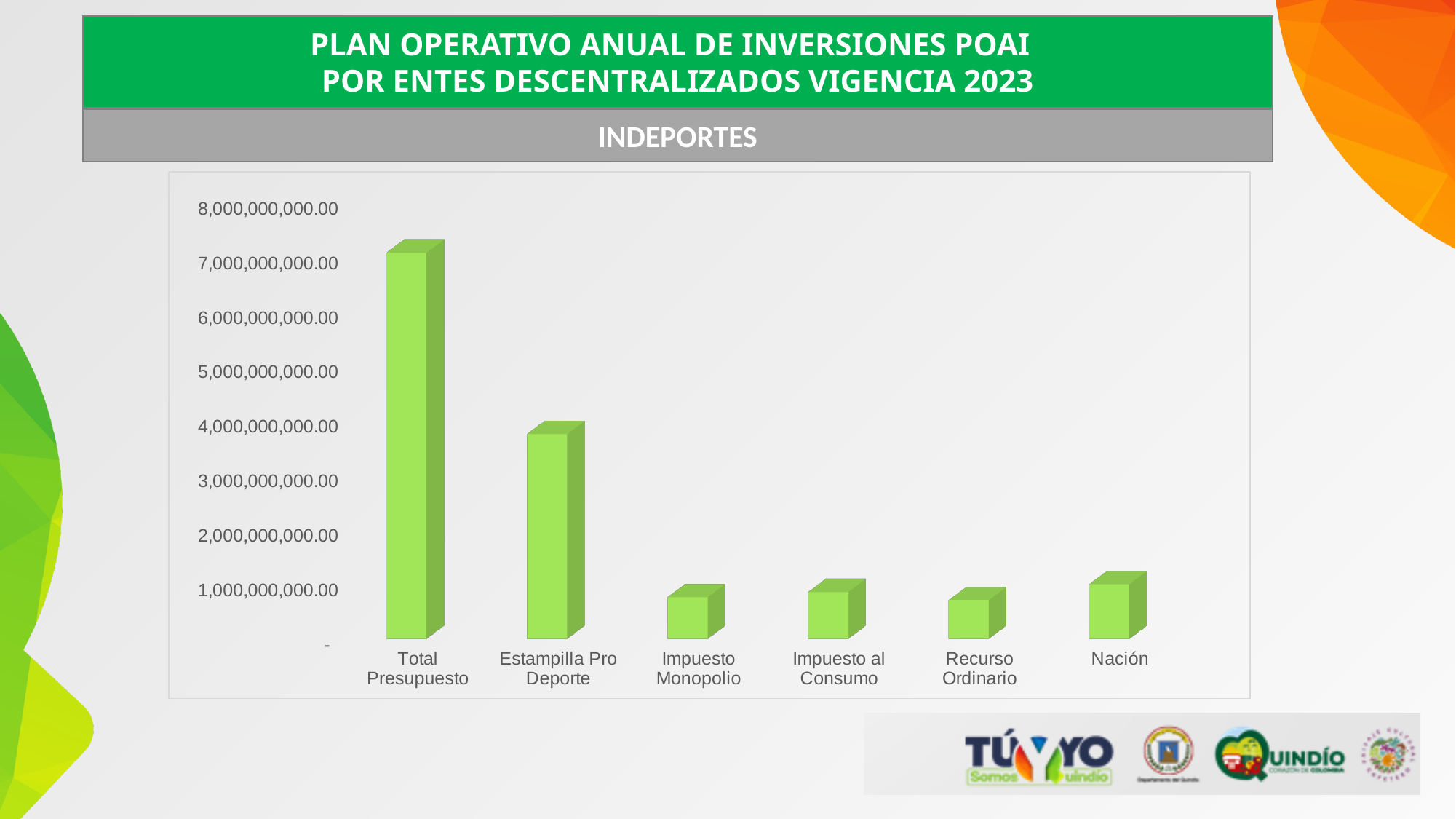
What kind of chart is shown on the slide? bar chart Which category has the highest bar in the chart? Total Presupuesto Which is larger, the value for Total Presupuesto or the value for Estampilla Pro Deporte? Total Presupuesto Which is larger, the value for Nación or the value for Impuesto Monopolio? Nación Is the value for Total Presupuesto greater or less than 6,000,000,000.00? greater Is the value for Impuesto Monopolio greater or less than 1,000,000,000.00? less What colour are the bars in the chart? green How many categories are plotted on the x axis of the chart? 6 Is the value for Estampilla Pro Deporte greater or less than 3,000,000,000.00? greater Which entity is named in the grey header bar above the chart? INDEPORTES